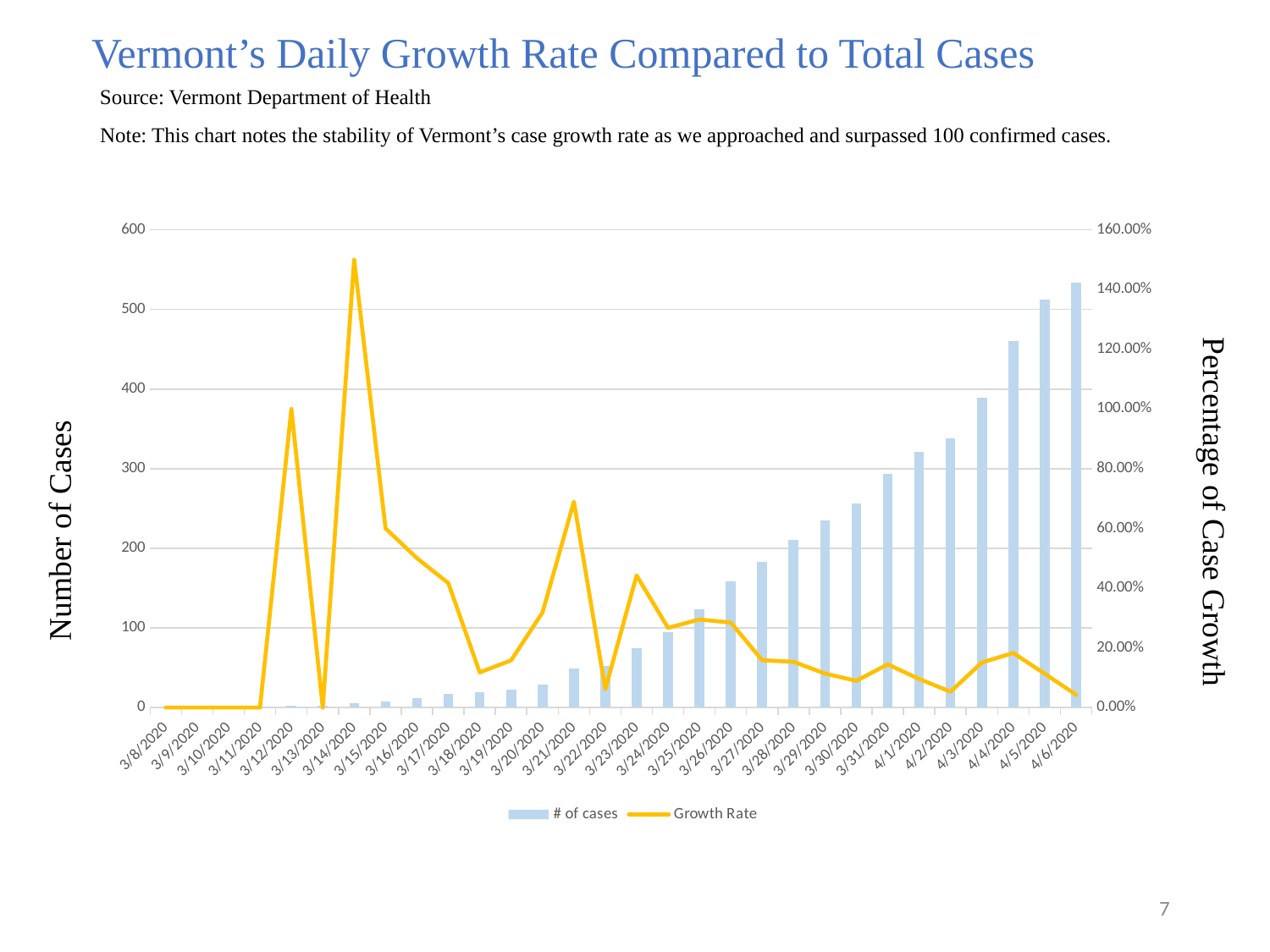
Is the Growth Rate for 3/14/2020 greater or less than 140.00%? greater How many dates are shown along the x axis? 30 Is the Growth Rate for 4/6/2020 greater or less than 20.00%? less What are the two series named in the legend? # of cases and Growth Rate Which date has a higher number of cases, 4/4/2020 or 4/1/2020? 4/4/2020 How many series does the legend list? 2 Do the number of cases bars generally rise or fall from 3/8/2020 to 4/6/2020? rise Is the number of cases for 4/6/2020 greater or less than 500? greater On which date is the number of cases bar the highest? 4/6/2020 On which date does the Growth Rate line reach its highest point? 3/14/2020 What kind of chart is shown on the slide? A combination bar and line chart